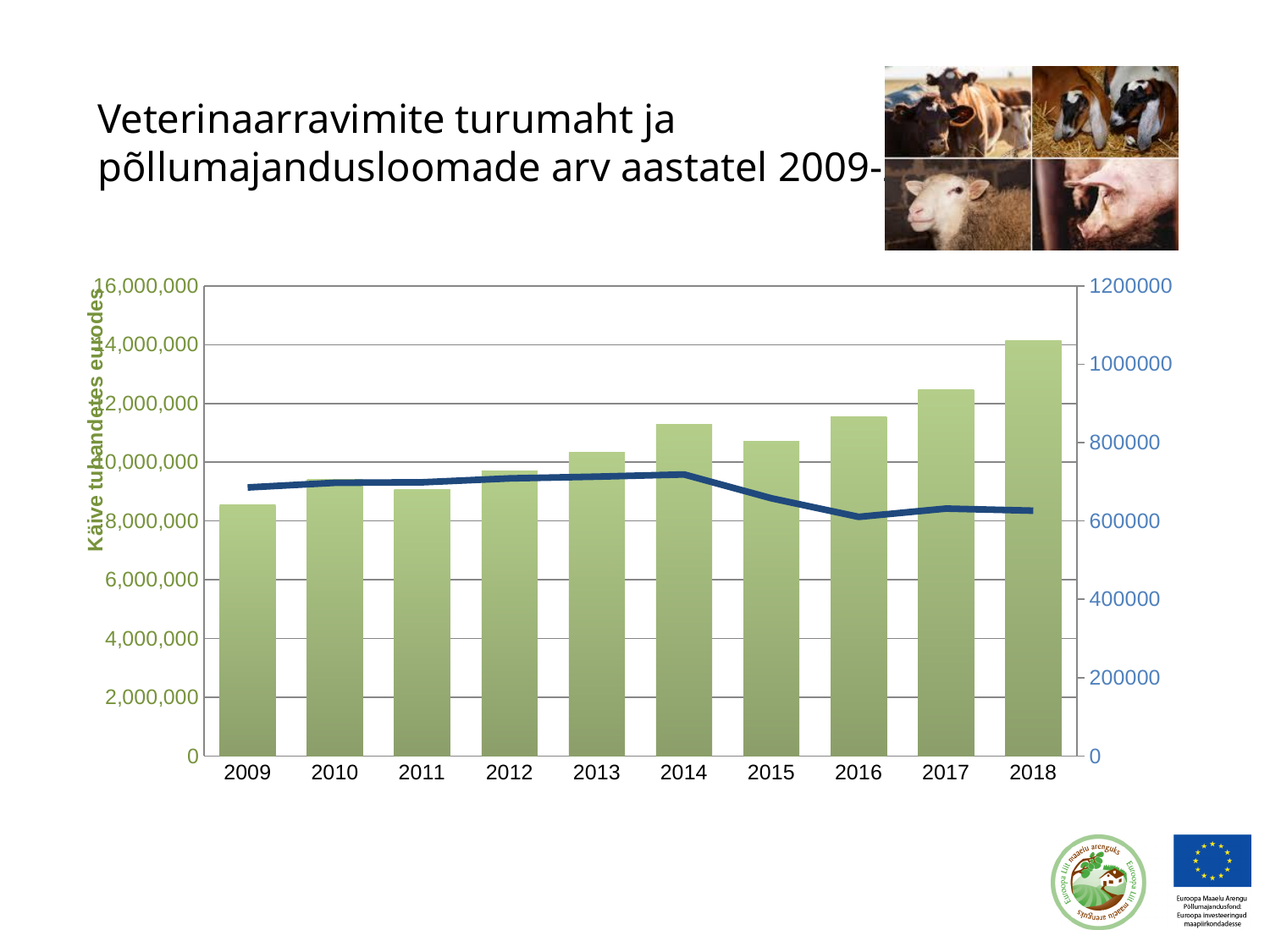
Is the bar value for 2009 greater or less than 10,000,000? less Is the bar value for 2014 greater or less than 10,000,000? greater Which year has the larger bar, 2014 or 2015? 2014 How many years are shown on the x axis of the chart? 10 What is the label on the left vertical axis of the chart? Käive tuhandetes eurodes Is the bar value for 2018 greater or less than 12,000,000? greater Which year has the shortest bar in the chart? 2009 Does the line rise or fall from 2014 to 2016? fall Do the bars generally rise or fall from 2009 to 2018? rise What kind of chart is shown on the slide? A combined bar and line chart Which year has the tallest bar in the chart? 2018